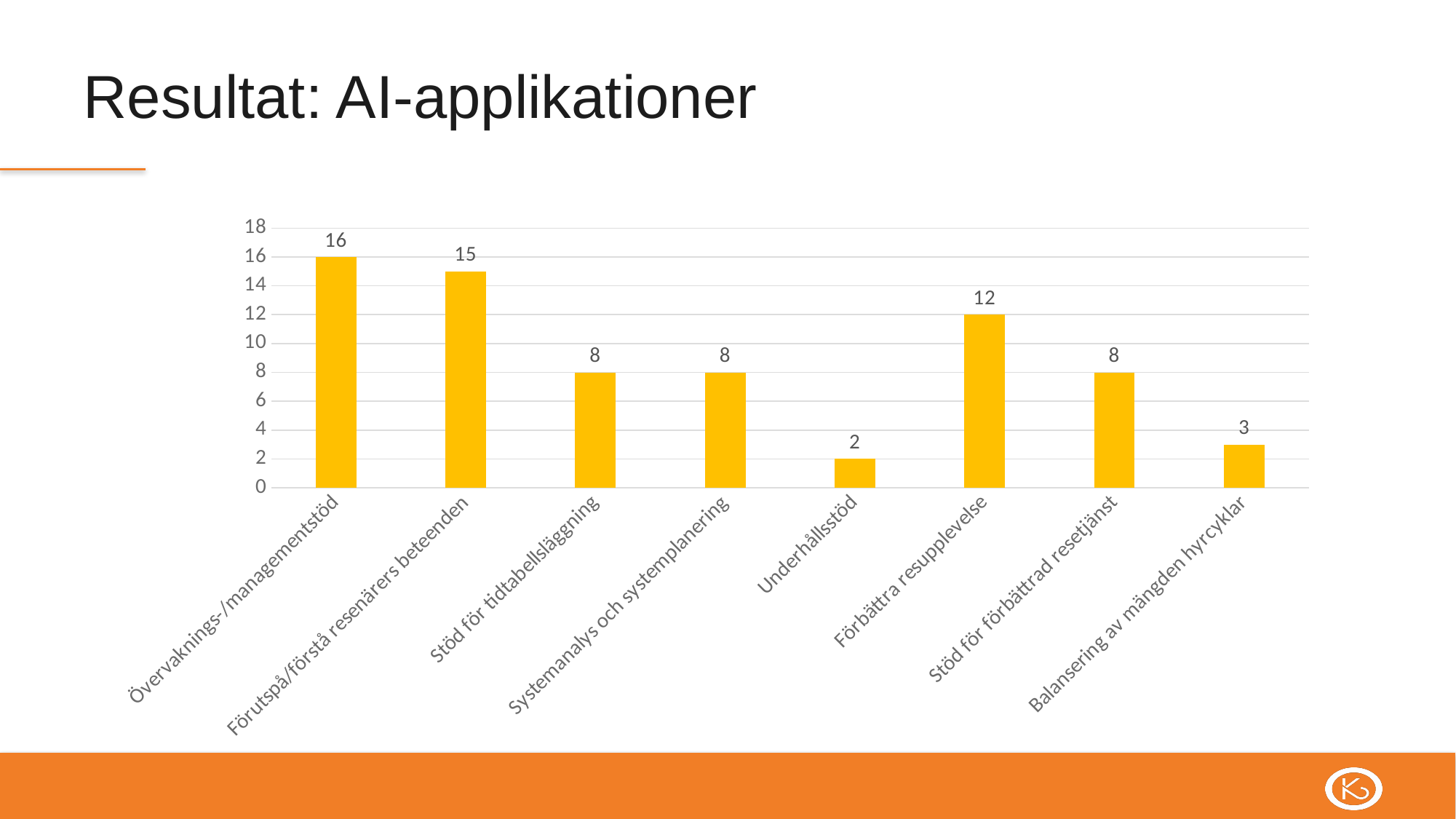
Which is larger, the value for Förbättra resupplevelse or the value for Systemanalys och systemplanering? Förbättra resupplevelse What is the value for Balansering av mängden hyrcyklar? 3 What is the value for Övervaknings-/managementstöd? 16 Which category has the lowest value? Underhållsstöd Which category has the highest value? Övervaknings-/managementstöd What is the value for Förbättra resupplevelse? 12 What is the difference between the values for Förbättra resupplevelse and Stöd för förbättrad resetjänst? 4 What kind of chart is shown on the slide? Bar chart How many categories are shown in the chart? 8 What is the difference between the values for Övervaknings-/managementstöd and Förutspå/förstå resenärers beteenden? 1 What is the value for Underhållsstöd? 2 What is the title of the slide containing the chart? Resultat: AI-applikationer